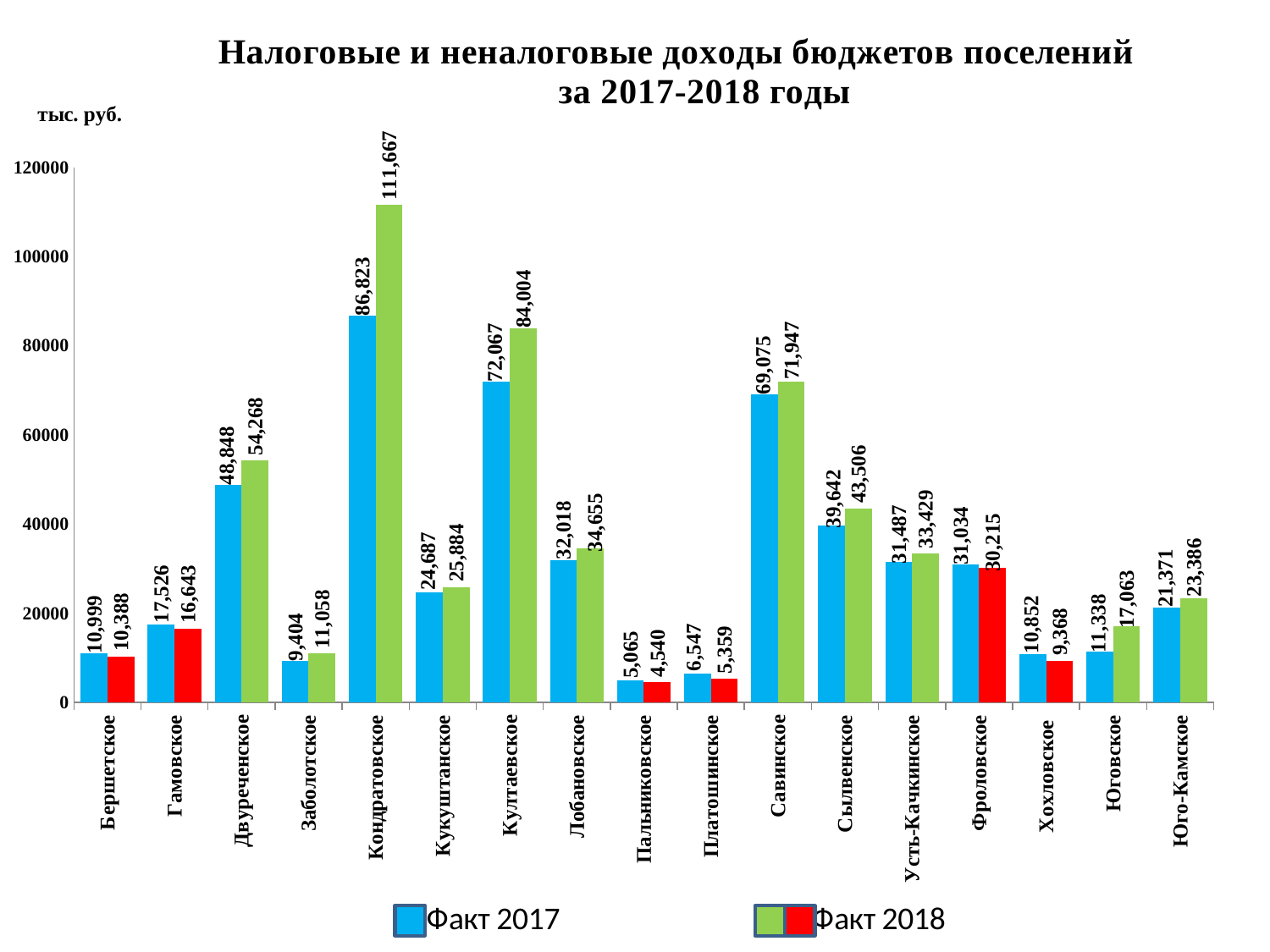
Which settlement has the lowest Факт 2017 value? Пальниковское What is the difference between the Факт 2018 and Факт 2017 values for Юговское? 5,725 What is the Факт 2018 value for Хохловское? 9,368 How many series does the legend list? 2 Is the Факт 2018 value for Култаевское greater or less than 80000? greater What is the Факт 2018 value for Кондратовское? 111,667 What is the difference between the Факт 2018 and Факт 2017 values for Кондратовское? 24,844 What kind of chart is shown on the slide? Bar chart Which is larger for Фроловское: the Факт 2017 value or the Факт 2018 value? Факт 2017 Which settlement has the highest Факт 2018 value? Кондратовское What is the Факт 2017 value for Савинское? 69,075 How many settlements are shown on the x axis? 17